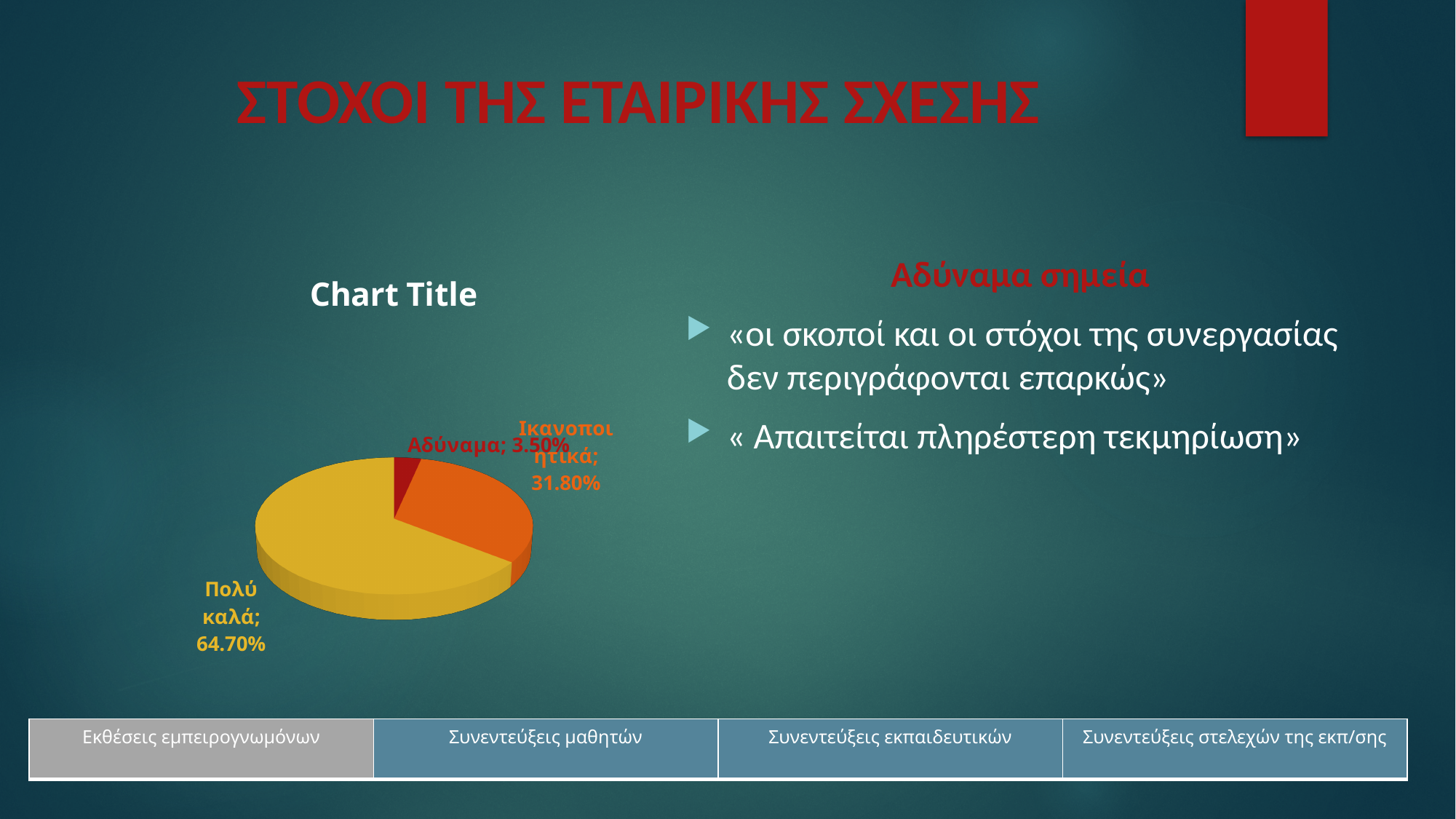
Which category has the largest share of the pie chart? Πολύ καλά What is the value for the "Ικανοποιητικά" slice of the pie chart? 31.80% What is the value for the "Πολύ καλά" slice of the pie chart? 64.70% What colour is the "Πολύ καλά" slice of the pie chart? Yellow What is the value for the "Αδύναμα" slice of the pie chart? 3.50% How many slices does the pie chart have? 3 What is the difference between the "Πολύ καλά" and "Ικανοποιητικά" values in the pie chart? 32.90% Which category has the smallest share of the pie chart? Αδύναμα What is the title of the pie chart? Chart Title What is the difference between the "Ικανοποιητικά" and "Αδύναμα" values in the pie chart? 28.30% Which is larger in the pie chart, "Ικανοποιητικά" or "Αδύναμα"? Ικανοποιητικά What kind of chart is shown on the slide? Pie chart